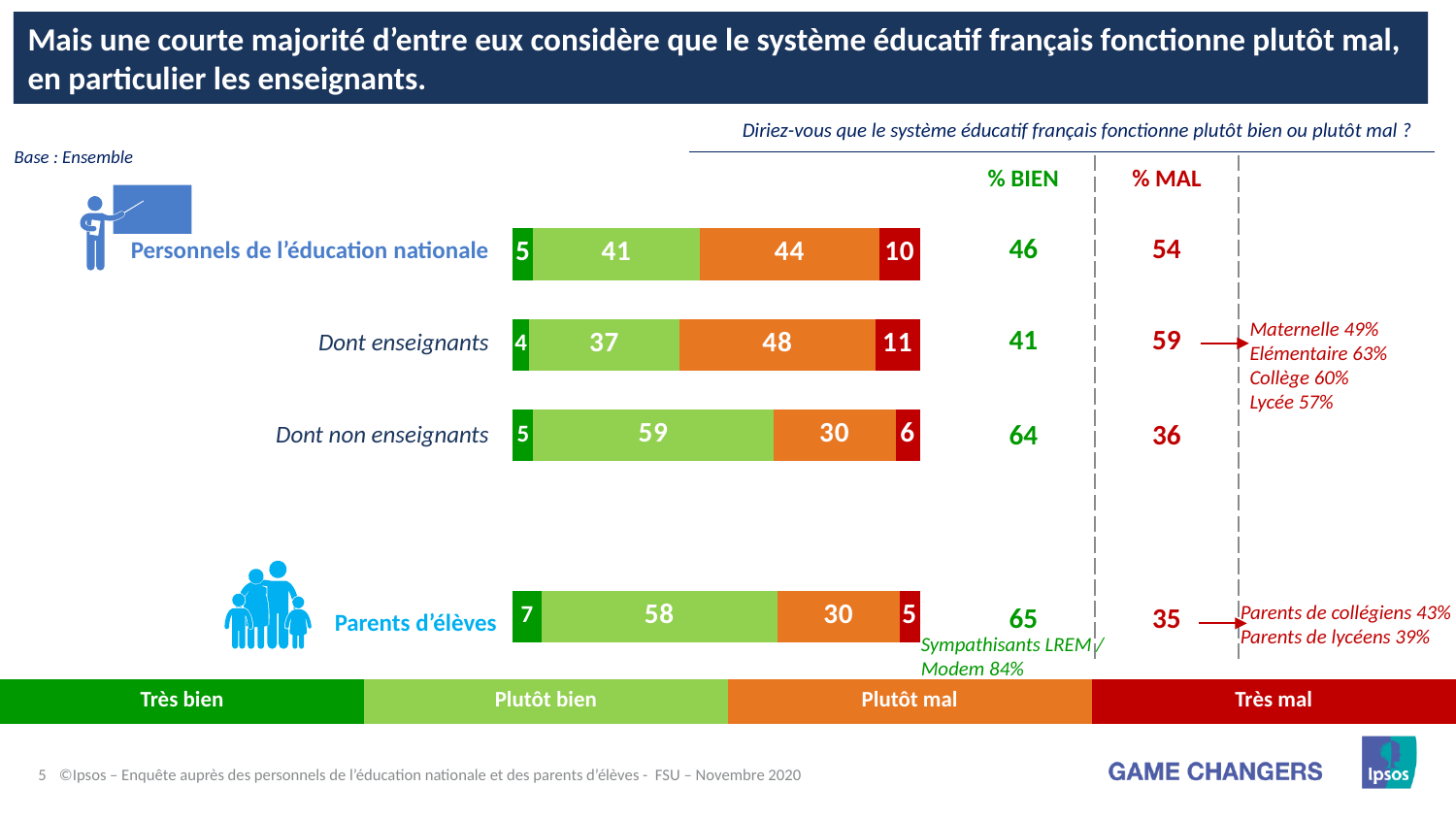
What is the '% BIEN' value for 'Dont non enseignants'? 64 What kind of chart is shown on the slide? Stacked bar chart How many categories (rows) are plotted in the chart? 4 What are the four legend entries shown at the bottom of the chart? Très bien, Plutôt bien, Plutôt mal, Très mal How many series does the legend at the bottom list? 4 What is the difference between the '% MAL' values for 'Dont enseignants' and 'Dont non enseignants'? 23 Which category has the highest 'Plutôt mal' value? Dont enseignants Which category has the lowest 'Très mal' value? Parents d'élèves Which is larger: the 'Plutôt bien' value for 'Dont non enseignants' or for 'Parents d'élèves'? Dont non enseignants What is the 'Plutôt mal' value for 'Dont enseignants'? 48 What is the 'Très mal' value for 'Personnels de l'éducation nationale'? 10 What is the 'Plutôt bien' value for 'Parents d'élèves'? 58